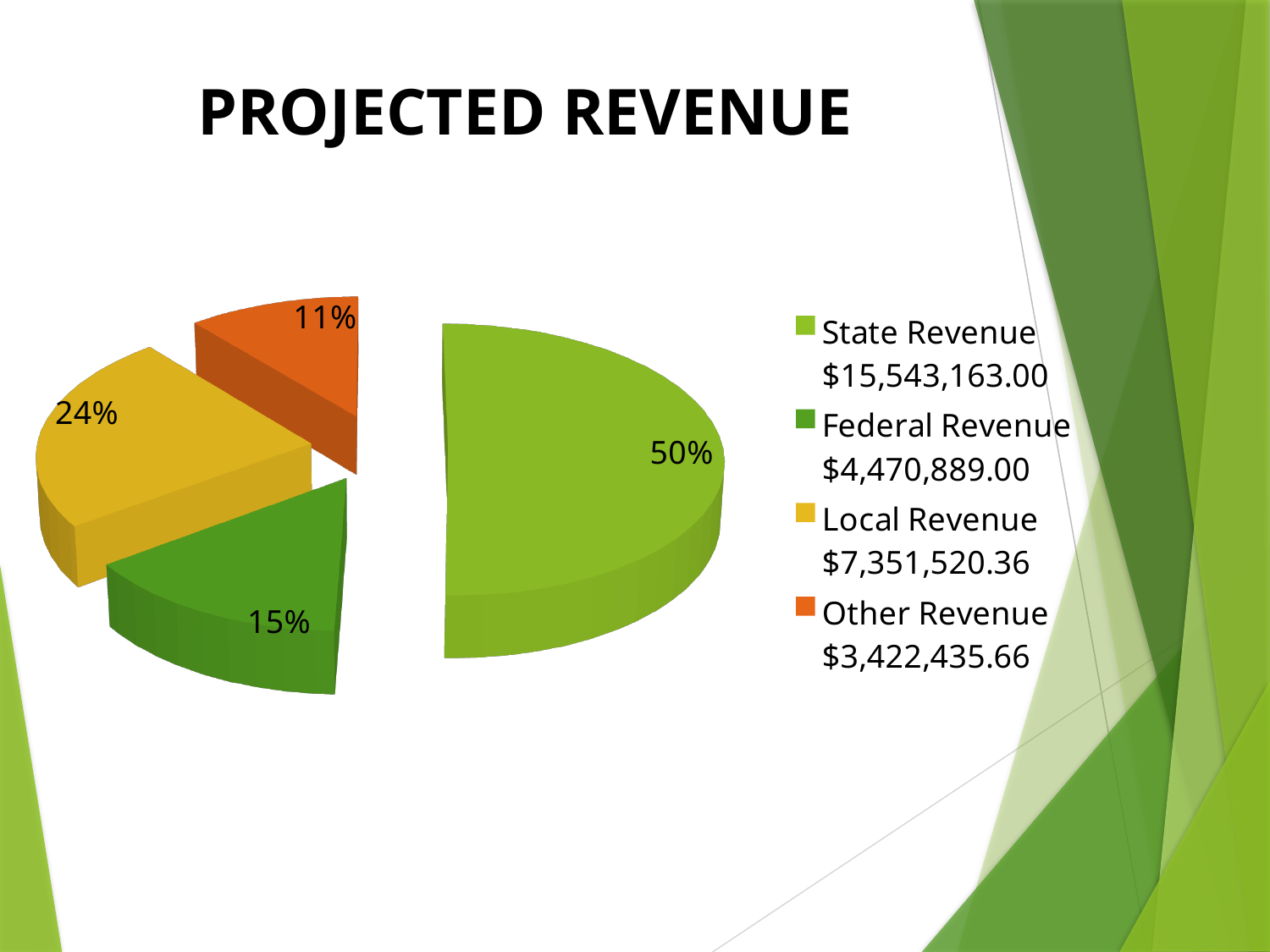
What is the difference in percentage points between the State Revenue slice and the Local Revenue slice? 26 percentage points What is the title of the chart? PROJECTED REVENUE How many categories does the pie chart show? 4 What share of the pie does Federal Revenue represent? 15% What share of the pie does Other Revenue represent? 11% What share of the pie does State Revenue represent? 50% Which revenue category has the largest slice of the pie? State Revenue What colour is the Other Revenue slice? Orange Which slice is larger, Federal Revenue or Local Revenue? Local Revenue Which revenue category has the smallest slice of the pie? Other Revenue What kind of chart is shown on the slide? Pie chart